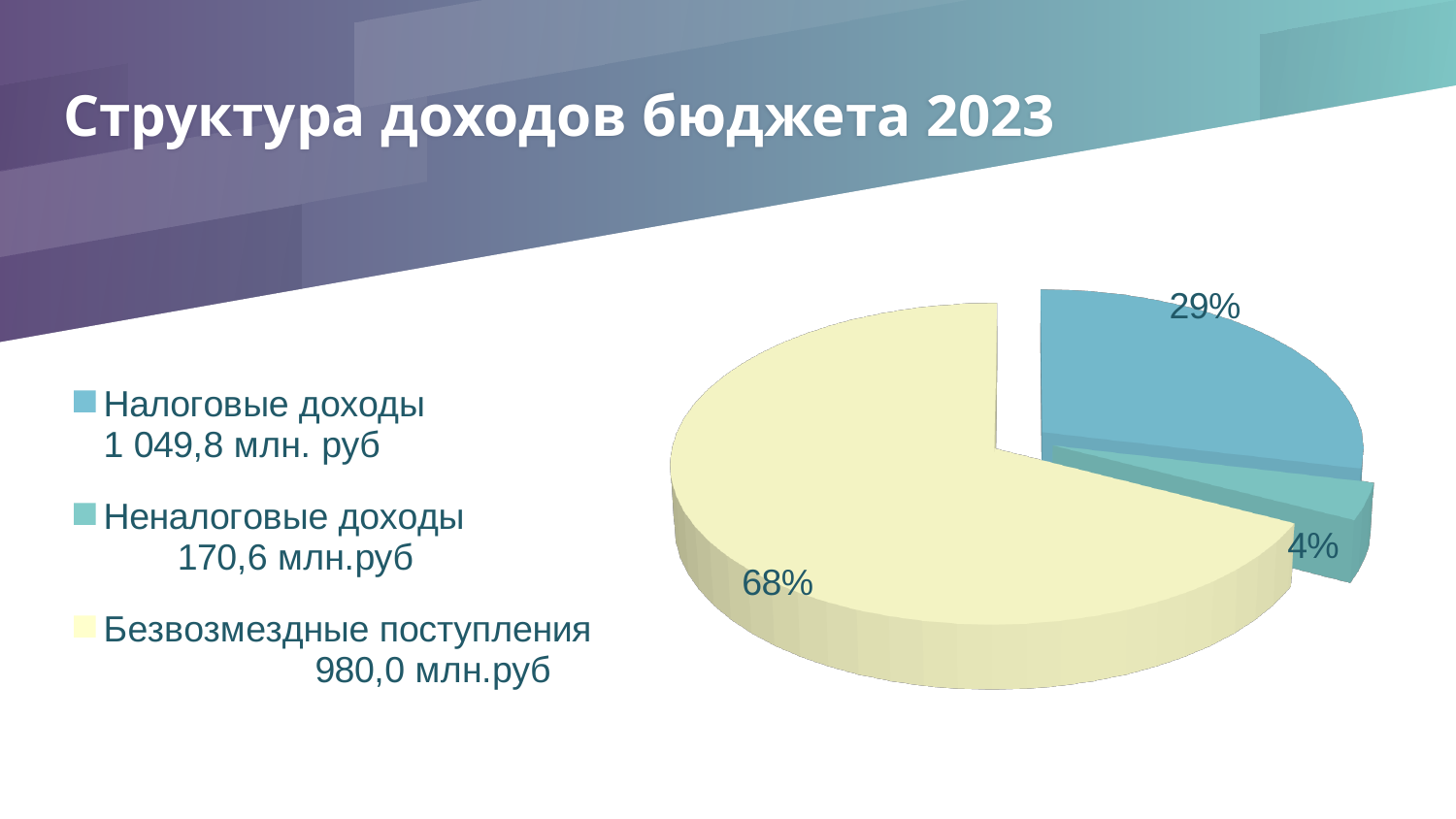
How many entries does the legend list? 3 What colour is the Безвозмездные поступления slice? Yellow How many slices does the pie chart have? 3 What kind of chart is shown on the slide? Pie chart What percentage share is shown for the Неналоговые доходы slice? 4% What value does the legend give for Безвозмездные поступления? 980,0 млн.руб Which slice has the smallest share of the pie? Неналоговые доходы What percentage share is shown for the Налоговые доходы slice? 29% Which slice has the largest share of the pie? Безвозмездные поступления What value does the legend give for Неналоговые доходы? 170,6 млн.руб What is the chart's title? Структура доходов бюджета 2023 What percentage share is shown for the Безвозмездные поступления slice? 68%